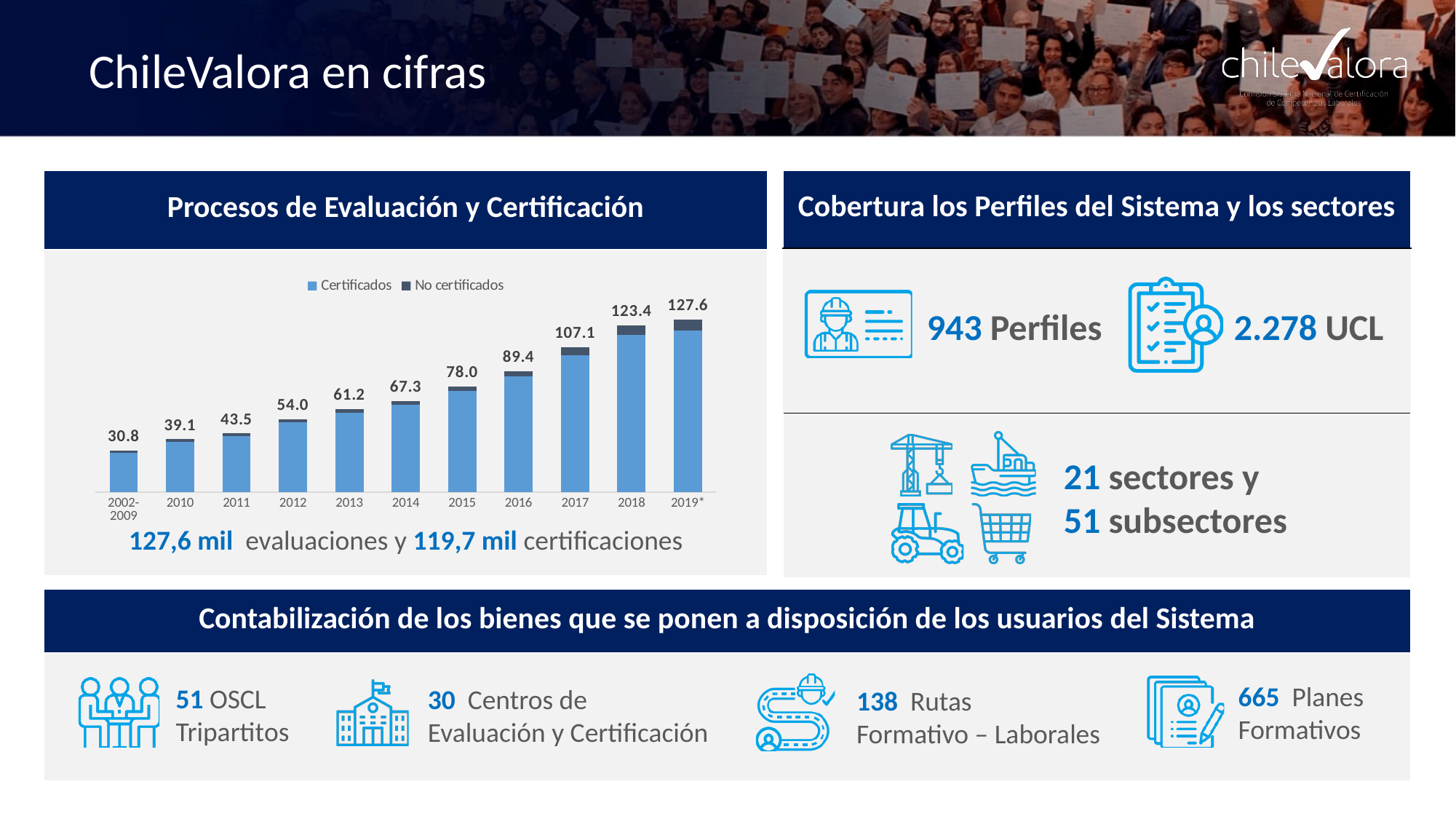
What is the total value labelled for 2002-2009 in the "Procesos de Evaluación y Certificación" chart? 30.8 Which category has the highest total in the "Procesos de Evaluación y Certificación" chart? 2019* What is the total value labelled for 2017 in the "Procesos de Evaluación y Certificación" chart? 107.1 What is the total value labelled for 2015 in the "Procesos de Evaluación y Certificación" chart? 78.0 What is the difference between the total for 2018 and the total for 2017 in the "Procesos de Evaluación y Certificación" chart? 16.3 How many categories are shown on the x axis of the "Procesos de Evaluación y Certificación" chart? 11 How many series does the legend of the "Procesos de Evaluación y Certificación" chart list? 2 Do the total values in the "Procesos de Evaluación y Certificación" chart rise or fall from 2002-2009 to 2019*? Rise What type of chart is shown under "Procesos de Evaluación y Certificación"? Bar chart Which category has the lowest total in the "Procesos de Evaluación y Certificación" chart? 2002-2009 Which is larger in the "Procesos de Evaluación y Certificación" chart, the total for 2013 or the total for 2014? 2014 What are the two series named in the legend of the "Procesos de Evaluación y Certificación" chart? Certificados and No certificados